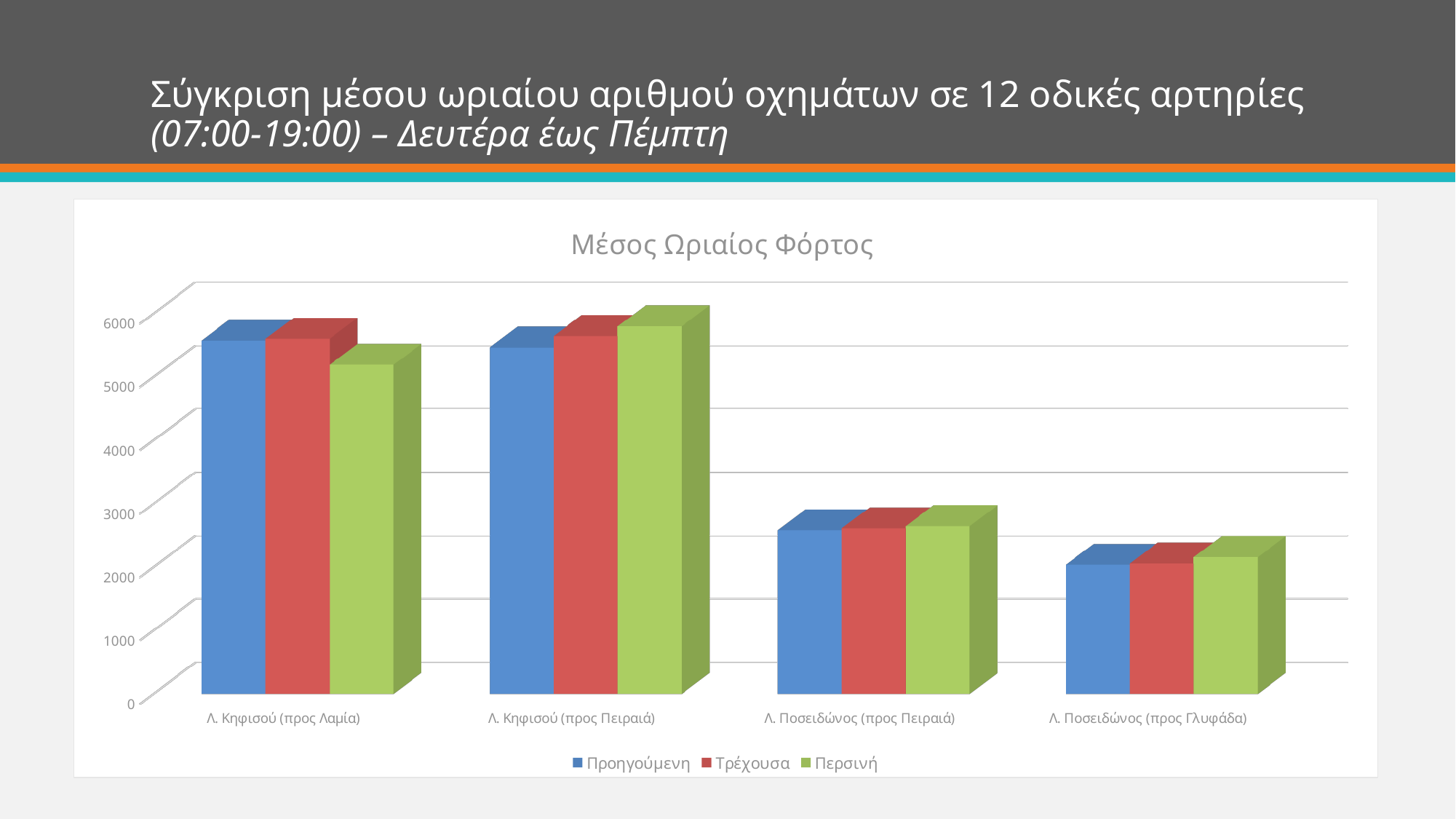
Which colour represents the series Τρέχουσα in the chart? Red For the series Περσινή, which is larger: Λ. Κηφισού (προς Πειραιά) or Λ. Ποσειδώνος (προς Γλυφάδα)? Λ. Κηφισού (προς Πειραιά) How many road categories are shown on the x axis of the chart? 4 How many series does the chart legend list? 3 Which category has the highest value for the series Περσινή? Λ. Κηφισού (προς Πειραιά) Which category has the lowest value for the series Προηγούμενη? Λ. Ποσειδώνος (προς Γλυφάδα) For the series Τρέχουσα, which is larger: Λ. Κηφισού (προς Λαμία) or Λ. Ποσειδώνος (προς Πειραιά)? Λ. Κηφισού (προς Λαμία) What is the title of the chart? Μέσος Ωριαίος Φόρτος What kind of chart is shown on the slide? Bar chart Is the value for Περσινή at Λ. Ποσειδώνος (προς Πειραιά) greater or less than 4000? less Is the value for Προηγούμενη at Λ. Κηφισού (προς Λαμία) greater or less than 5000? greater Is the value for Προηγούμενη at Λ. Ποσειδώνος (προς Γλυφάδα) greater or less than 3000? less